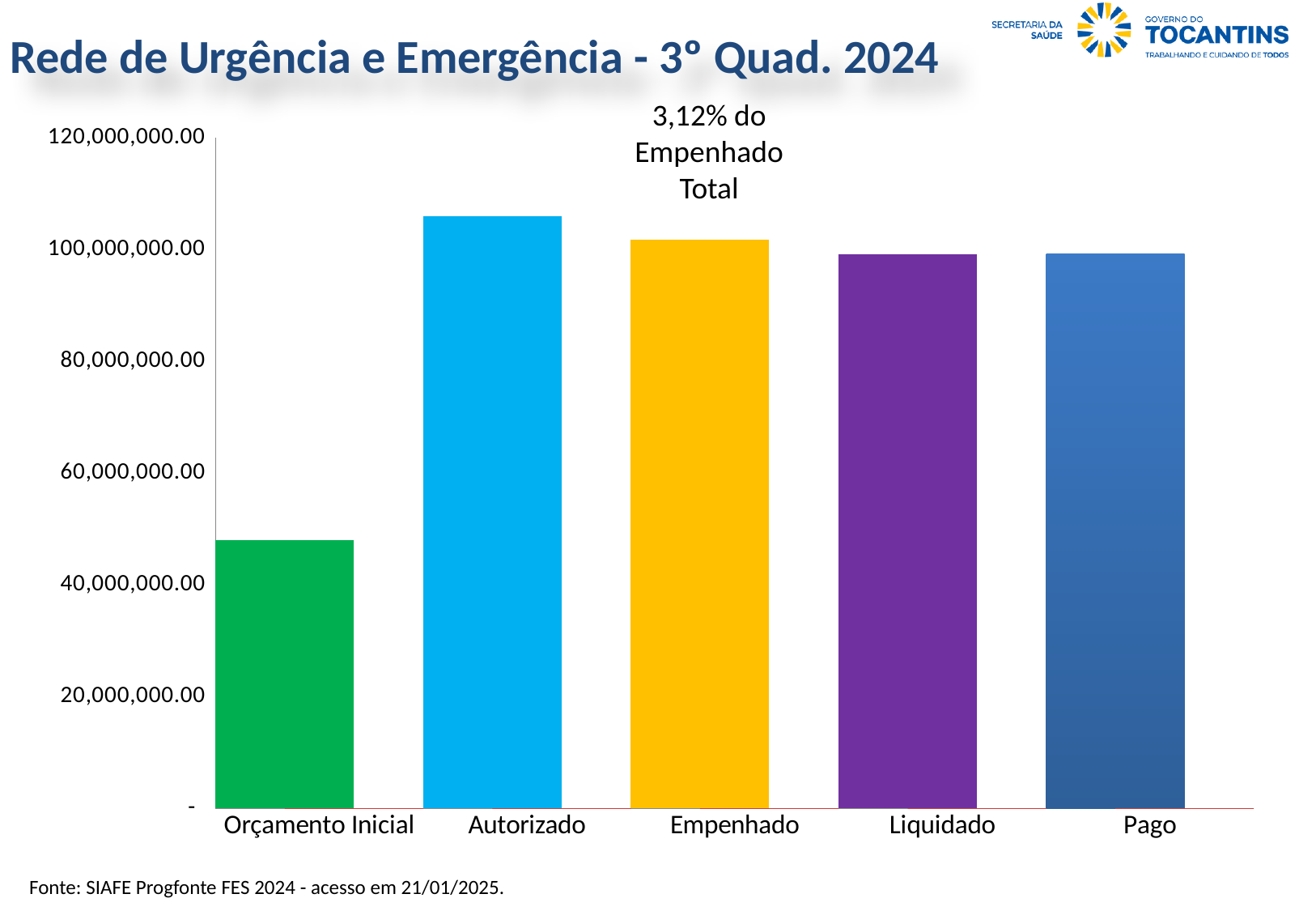
Is the value for Orçamento Inicial greater or less than 60,000,000.00? less How many categories are shown on the x axis of the chart? 5 What percentage is stated in the annotation above the Empenhado bar? 3,12% Is the value for Pago greater or less than 120,000,000.00? less Is the value for Liquidado greater or less than 80,000,000.00? greater What is the title of the slide containing the chart? Rede de Urgência e Emergência - 3° Quad. 2024 Which category has the lowest bar in the chart? Orçamento Inicial What kind of chart is shown on the slide? bar chart Which category has the highest bar in the chart? Autorizado Which is larger, the value for Autorizado or the value for Orçamento Inicial? Autorizado